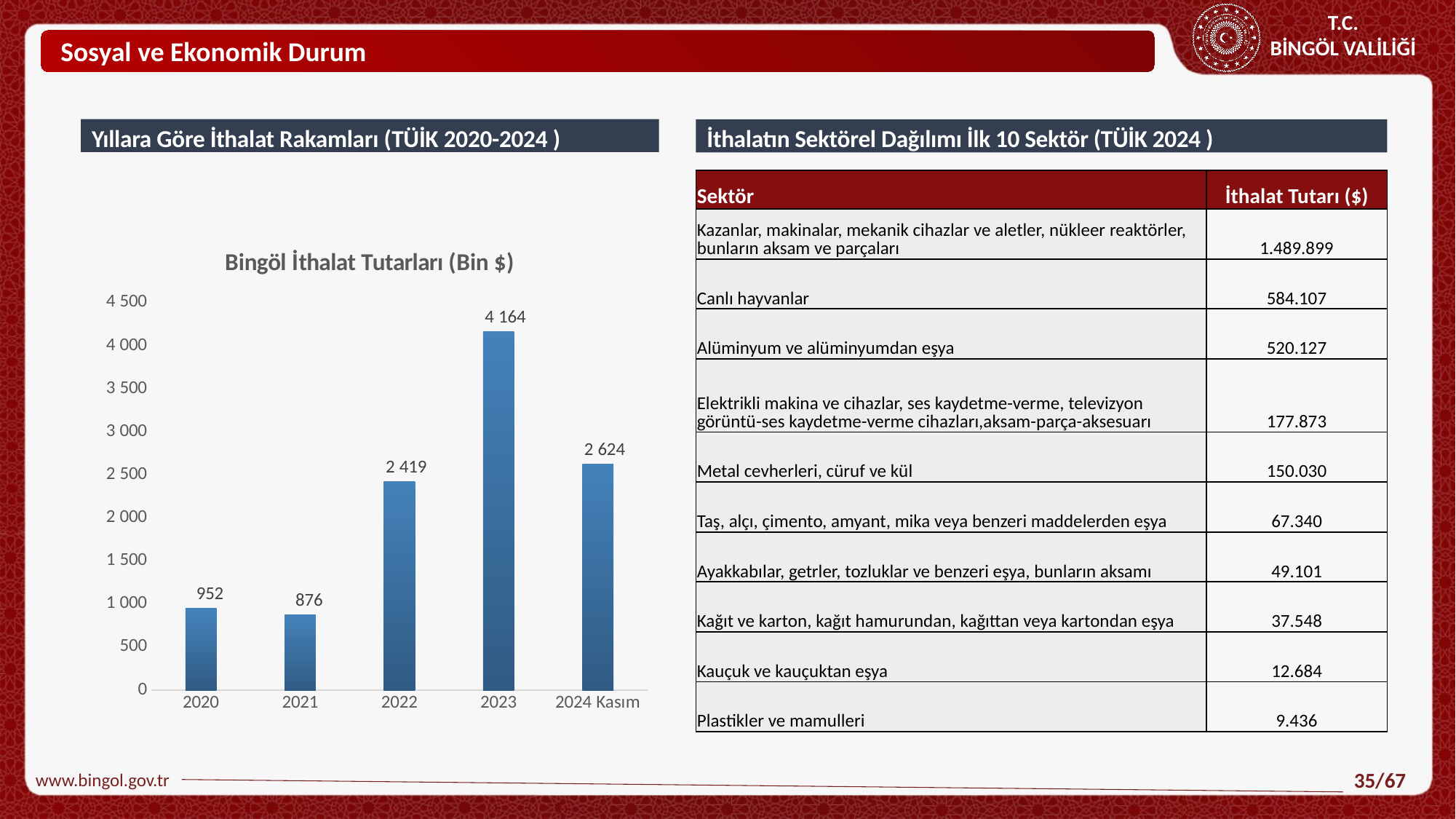
What is the difference between the 2020 and 2021 values in the Bingöl İthalat Tutarları (Bin $) chart? 76 What is the value for 2020 in the Bingöl İthalat Tutarları (Bin $) chart? 952 How many bars are shown in the Bingöl İthalat Tutarları (Bin $) chart? 5 What is the value for 2024 Kasım in the Bingöl İthalat Tutarları (Bin $) chart? 2 624 Is the value for 2022 in the Bingöl İthalat Tutarları (Bin $) chart greater or less than 2 000? greater What is the difference between the 2023 and 2022 values in the Bingöl İthalat Tutarları (Bin $) chart? 1 745 What is the value for 2023 in the Bingöl İthalat Tutarları (Bin $) chart? 4 164 What kind of chart is the Bingöl İthalat Tutarları (Bin $) chart? bar chart What is the title of the chart on the left side of the slide? Bingöl İthalat Tutarları (Bin $) In the Bingöl İthalat Tutarları (Bin $) chart, which is larger: the value for 2022 or the value for 2024 Kasım? 2024 Kasım Which year has the highest value in the Bingöl İthalat Tutarları (Bin $) chart? 2023 Which year has the lowest value in the Bingöl İthalat Tutarları (Bin $) chart? 2021